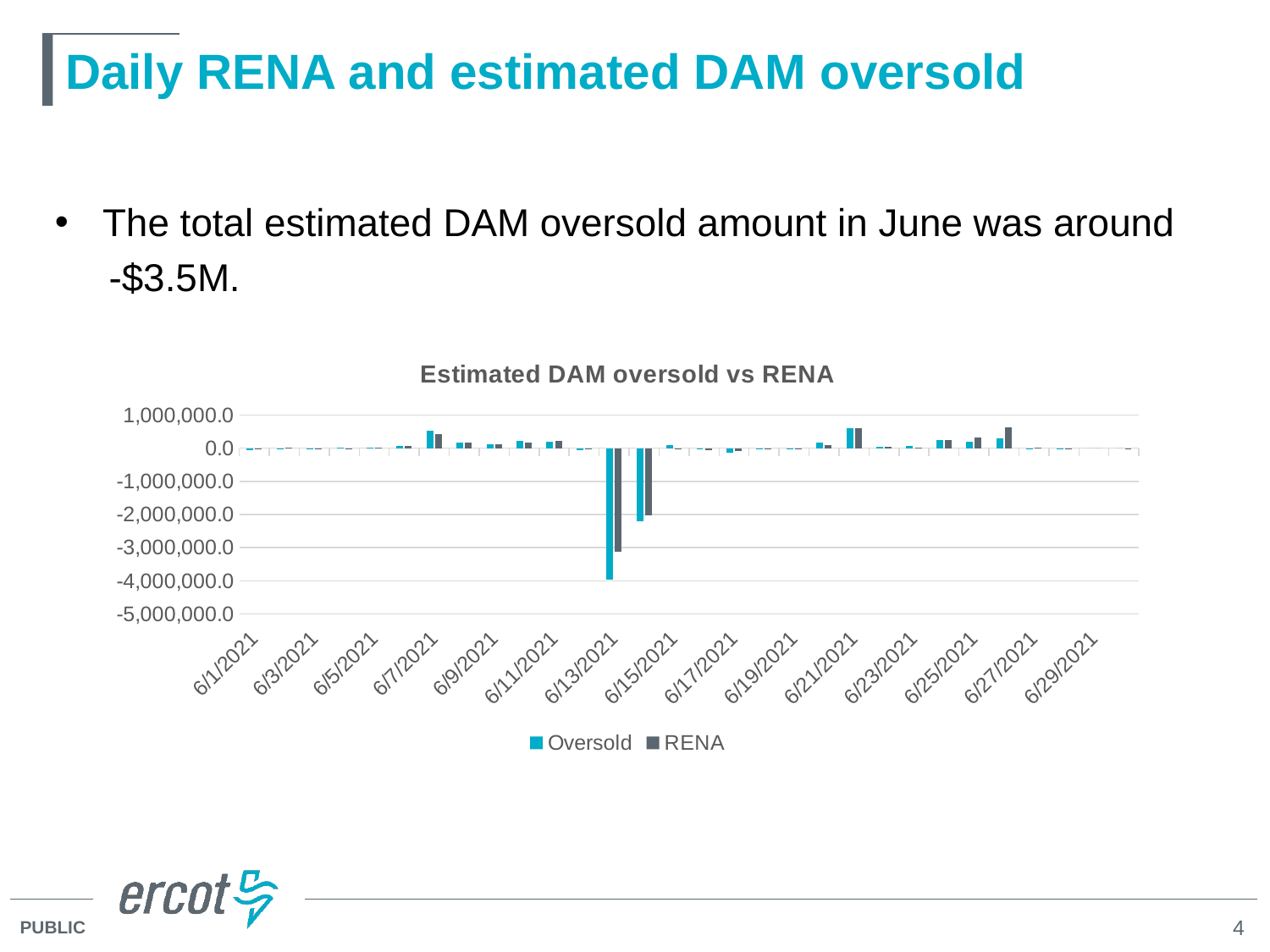
Is the Oversold value on 6/1/2021 greater or less than -1,000,000.0? greater What are the two series named in the chart legend? Oversold and RENA On which date does the Oversold series reach its lowest value? 6/13/2021 On 6/13/2021, which series has the lower value, Oversold or RENA? Oversold What kind of chart is shown on the slide? bar chart What is the title of the chart? Estimated DAM oversold vs RENA How many series does the chart legend list? 2 How many date labels are shown along the x axis? 15 Is the RENA value on 6/13/2021 greater or less than -2,000,000.0? less Is the Oversold value on 6/13/2021 greater or less than -3,000,000.0? less What is the lowest value shown on the y axis? -5,000,000.0